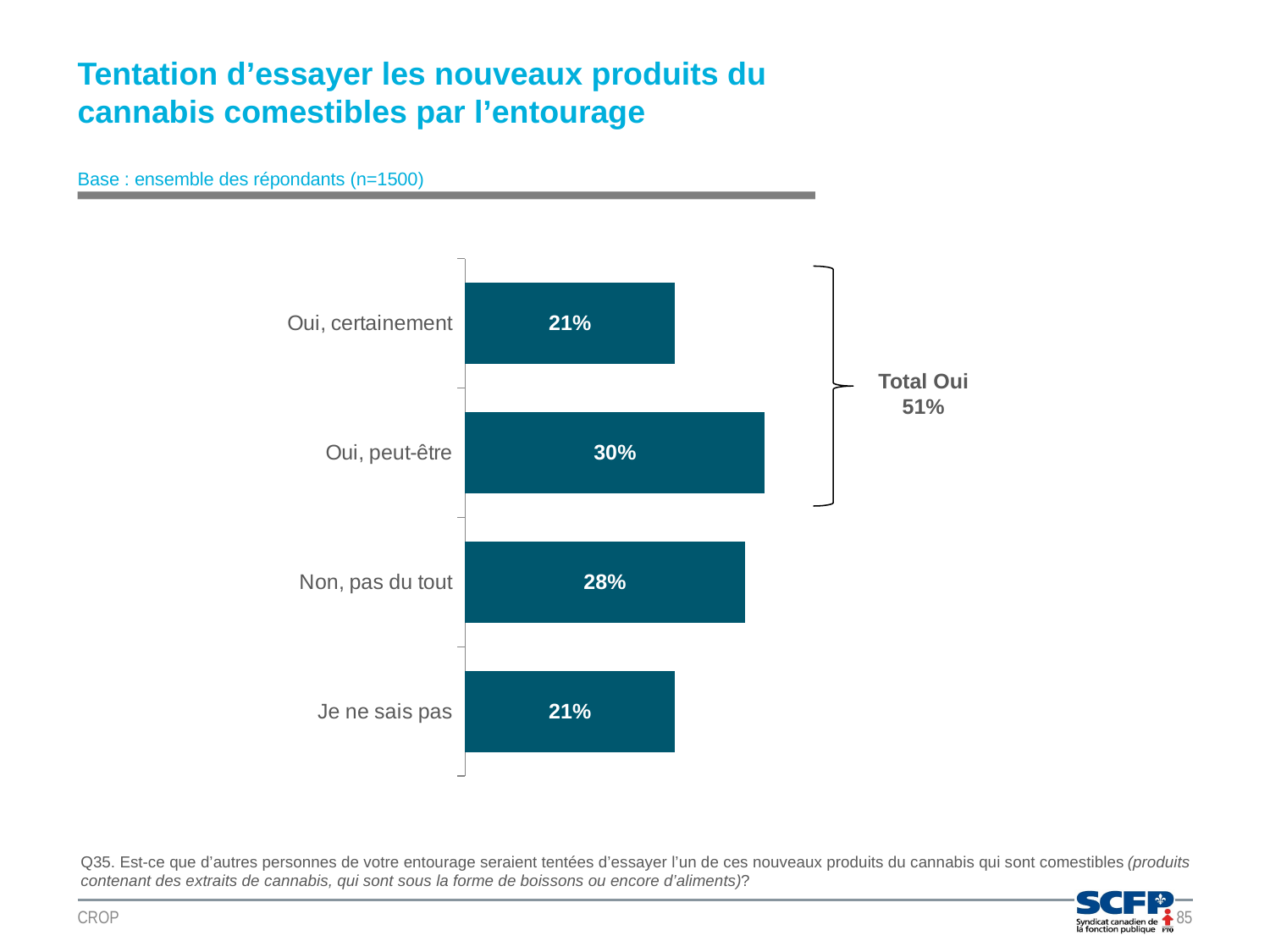
What is the value for "Je ne sais pas"? 21% What is the difference between "Oui, peut-être" and "Non, pas du tout"? 2% What is the value for "Oui, certainement"? 21% What is the base (n) stated for the chart? n=1500 What is the difference between "Oui, peut-être" and "Oui, certainement"? 9% Which category has the highest value? Oui, peut-être What is the value for "Oui, peut-être"? 30% What is the value for "Non, pas du tout"? 28% Which is larger, "Non, pas du tout" or "Je ne sais pas"? Non, pas du tout What is the "Total Oui" value shown next to the chart? 51% What kind of chart is shown on the slide? Bar chart How many categories are shown in the chart? 4